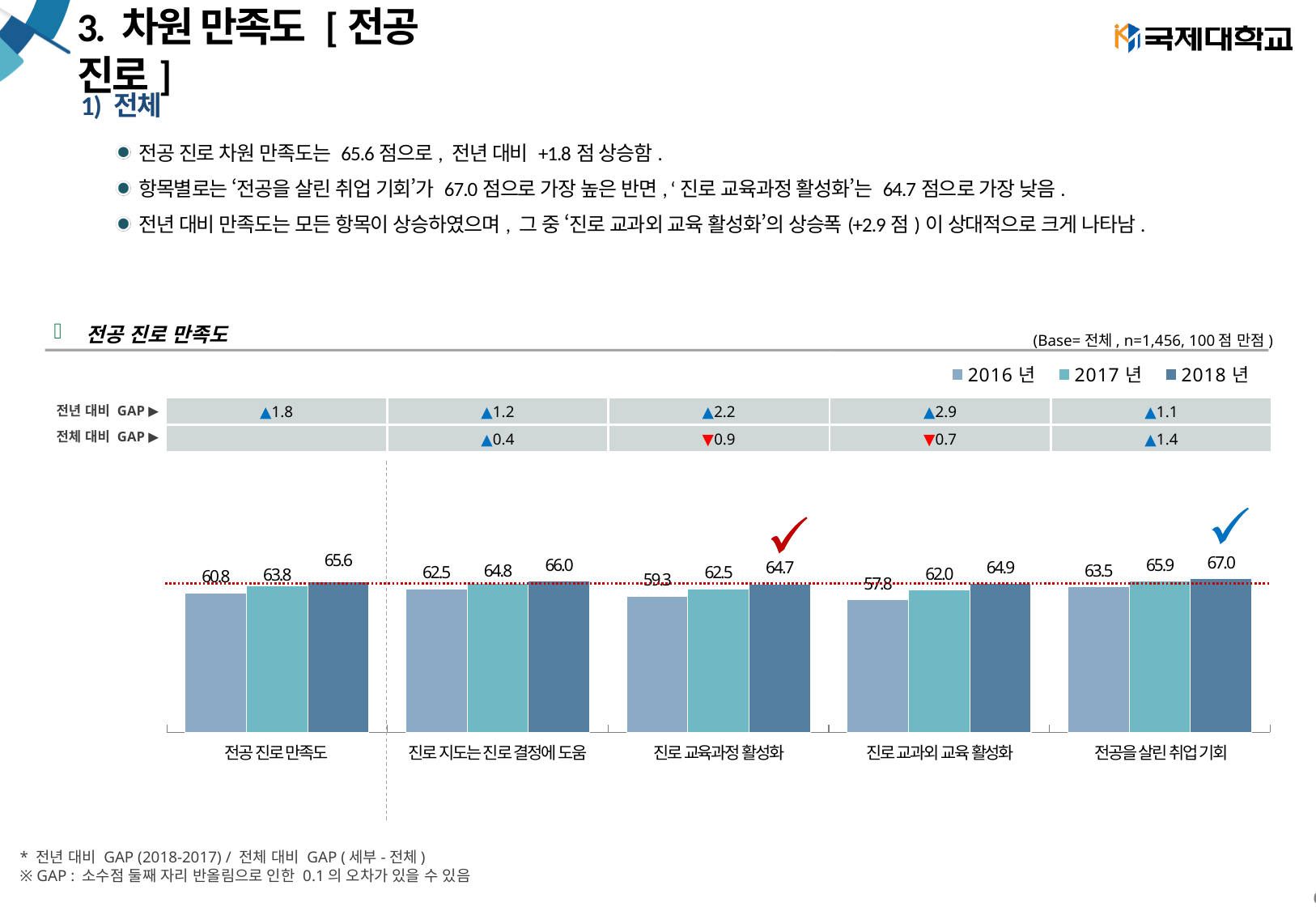
What is the difference between the 2018년 and 2017년 values for 진로 교과외 교육 활성화? 2.9 What is the 전년 대비 GAP shown for 진로 교육과정 활성화? ▲2.2 How many series does the legend list? 3 Which category has the lowest 2016년 value? 진로 교과외 교육 활성화 What type of chart is shown on the slide? bar chart What is the 2018년 value for 전공 진로만족도? 65.6 What is the 2017년 value for 진로 지도는 진로 결정에 도움? 64.8 Which is larger: the 2018년 value for 진로 교육과정 활성화 or the 2018년 value for 진로 지도는 진로 결정에 도움? 진로 지도는 진로 결정에 도움 For 전공을 살린 취업 기회, do the values rise or fall from 2016년 to 2018년? rise How many categories are shown along the x axis of the chart? 5 Which category has the highest 2018년 value? 전공을 살린 취업 기회 What is the 2016년 value for 진로 교과외 교육 활성화? 57.8